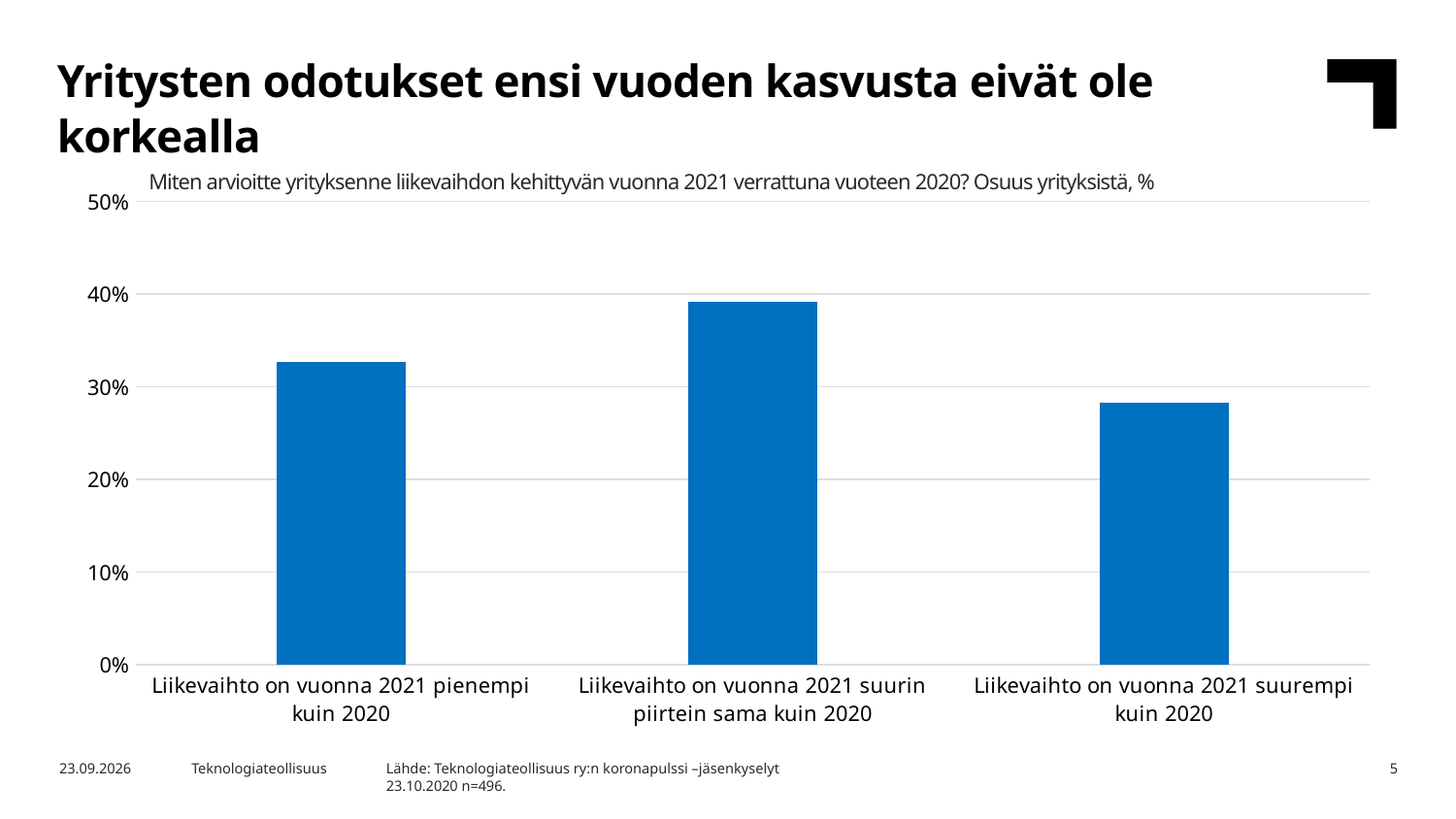
Is the value for 'Liikevaihto on vuonna 2021 suurempi kuin 2020' greater or less than 30%? less Which is larger: the value for 'Liikevaihto on vuonna 2021 pienempi kuin 2020' or for 'Liikevaihto on vuonna 2021 suurempi kuin 2020'? Liikevaihto on vuonna 2021 pienempi kuin 2020 What question is the chart's subtitle based on? Miten arvioitte yrityksenne liikevaihdon kehittyvän vuonna 2021 verrattuna vuoteen 2020? Osuus yrityksistä, % Which category has the highest value? Liikevaihto on vuonna 2021 suurin piirtein sama kuin 2020 Is the value for 'Liikevaihto on vuonna 2021 pienempi kuin 2020' greater or less than 30%? greater How many categories are plotted on the chart? 3 Does the value rise or fall from the first category to the second category along the x axis? rise What kind of chart is shown on the slide? bar chart Is the value for 'Liikevaihto on vuonna 2021 suurempi kuin 2020' greater or less than 20%? greater What colour are the bars in the chart? blue Which category has the lowest value? Liikevaihto on vuonna 2021 suurempi kuin 2020